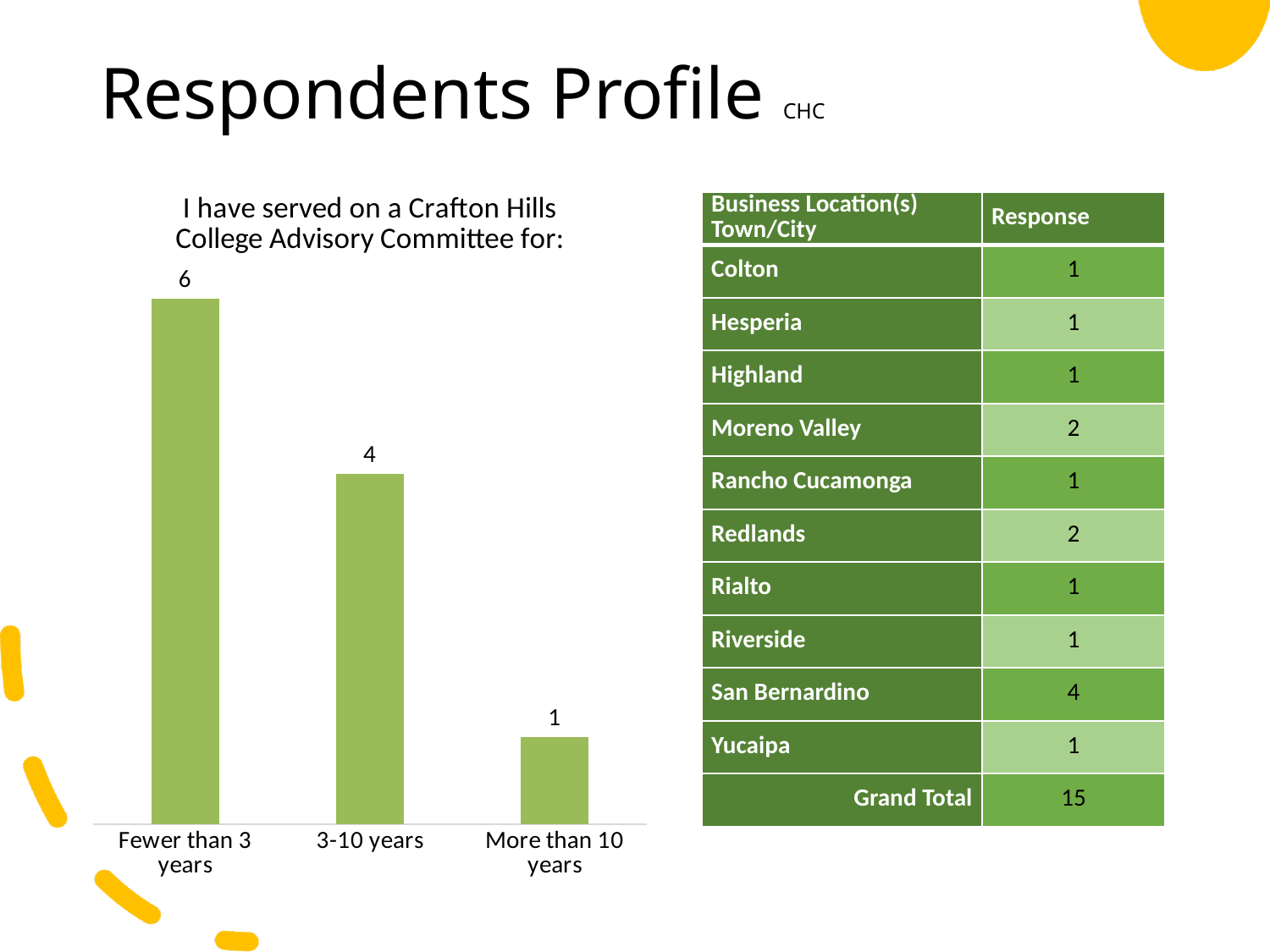
Which is larger, the value for "3-10 years" or the value for "More than 10 years"? 3-10 years What is the value for "3-10 years"? 4 What is the value for "More than 10 years"? 1 Which category has the highest value? Fewer than 3 years What is the difference between the values for "Fewer than 3 years" and "3-10 years"? 2 Do the values rise or fall from left to right along the x axis? Fall Which category has the lowest value? More than 10 years What is the title of the chart? I have served on a Crafton Hills College Advisory Committee for: How many categories are shown in the chart? 3 What kind of chart is shown on the slide? Bar chart What is the difference between the values for "3-10 years" and "More than 10 years"? 3 What is the value for "Fewer than 3 years"? 6